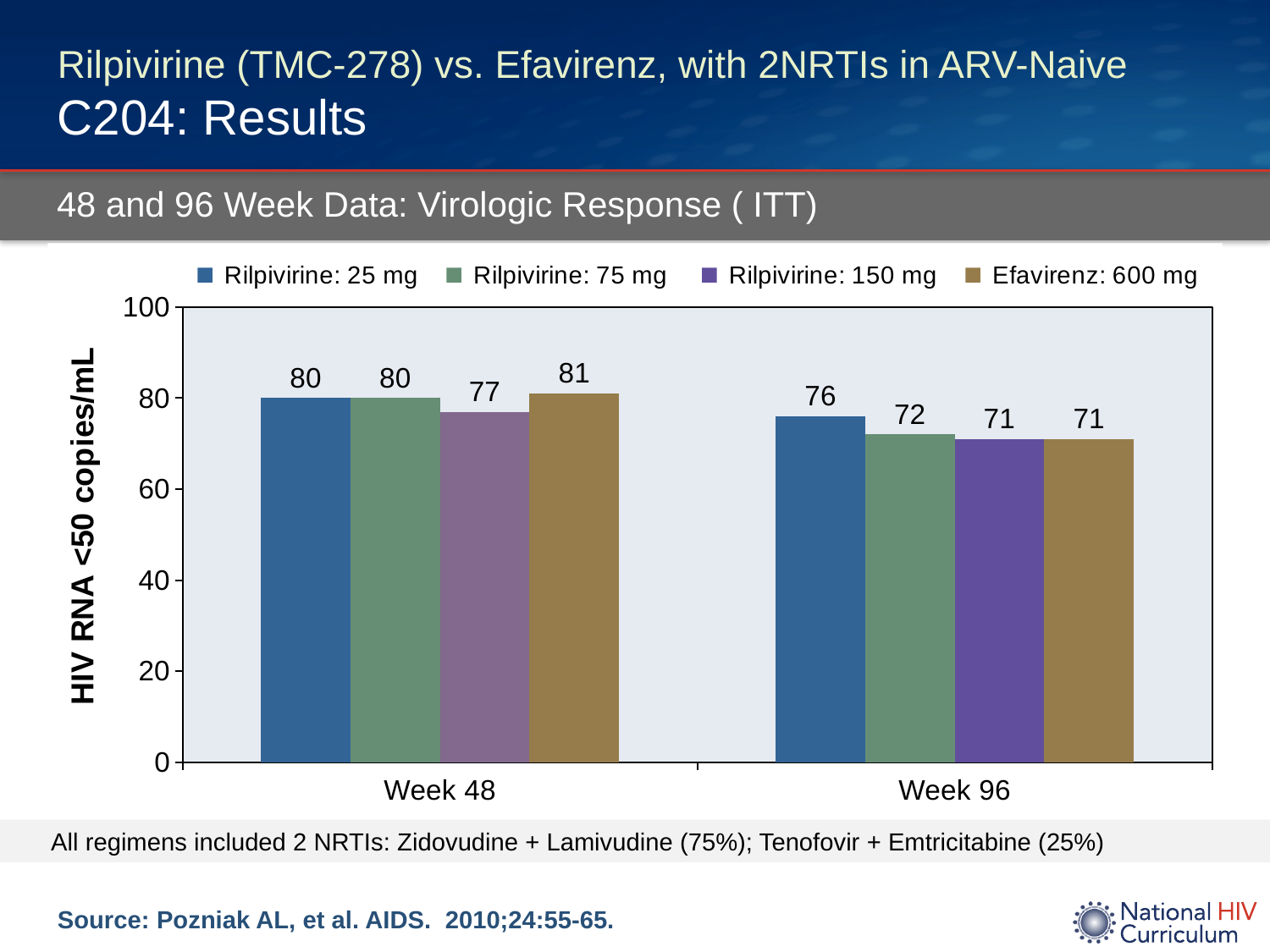
Which series has the highest value at Week 48? Efavirenz: 600 mg Which series has the lowest value at Week 48? Rilpivirine: 150 mg What kind of chart is shown on the slide? Bar chart Do the values for Efavirenz: 600 mg rise or fall from Week 48 to Week 96? Fall What is the difference between the Rilpivirine: 25 mg values at Week 48 and Week 96? 4 Which series has the highest value at Week 96? Rilpivirine: 25 mg Which is larger: Rilpivirine: 75 mg at Week 48 or Rilpivirine: 75 mg at Week 96? Week 48 What is the value for Rilpivirine: 25 mg at Week 48? 80 How many series does the legend list? 4 What is the value for Rilpivirine: 75 mg at Week 96? 72 What is the value for Rilpivirine: 150 mg at Week 48? 77 What is the value for Efavirenz: 600 mg at Week 96? 71